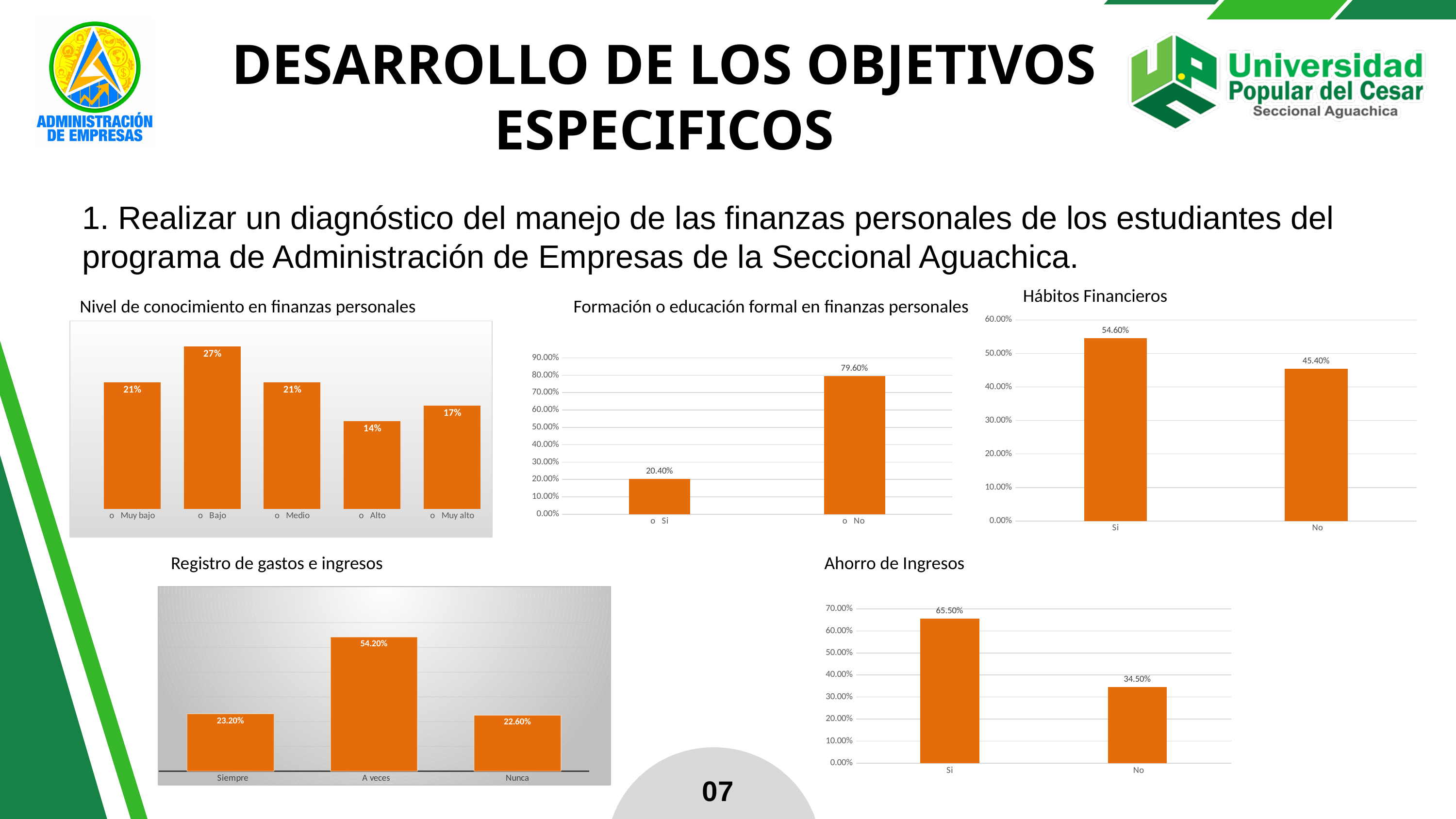
In the 'Hábitos Financieros' chart, which is larger, Si or No? Si In the 'Registro de gastos e ingresos' chart, what is the value for A veces? 54.20% In the 'Nivel de conocimiento en finanzas personales' chart, which category has the lowest value? Alto In the 'Registro de gastos e ingresos' chart, what is the difference between Siempre and Nunca? 0.60% In the 'Hábitos Financieros' chart, what is the value for Si? 54.60% How many categories does the 'Nivel de conocimiento en finanzas personales' chart show? 5 How many charts are shown on the slide? 5 In the 'Formación o educación formal en finanzas personales' chart, what is the difference between No and Si? 59.20% What kind of chart is the 'Ahorro de Ingresos' chart? Bar chart In the 'Formación o educación formal en finanzas personales' chart, what is the value for No? 79.60% In the 'Ahorro de Ingresos' chart, what is the value for No? 34.50% In the 'Nivel de conocimiento en finanzas personales' chart, what is the value for Bajo? 27%